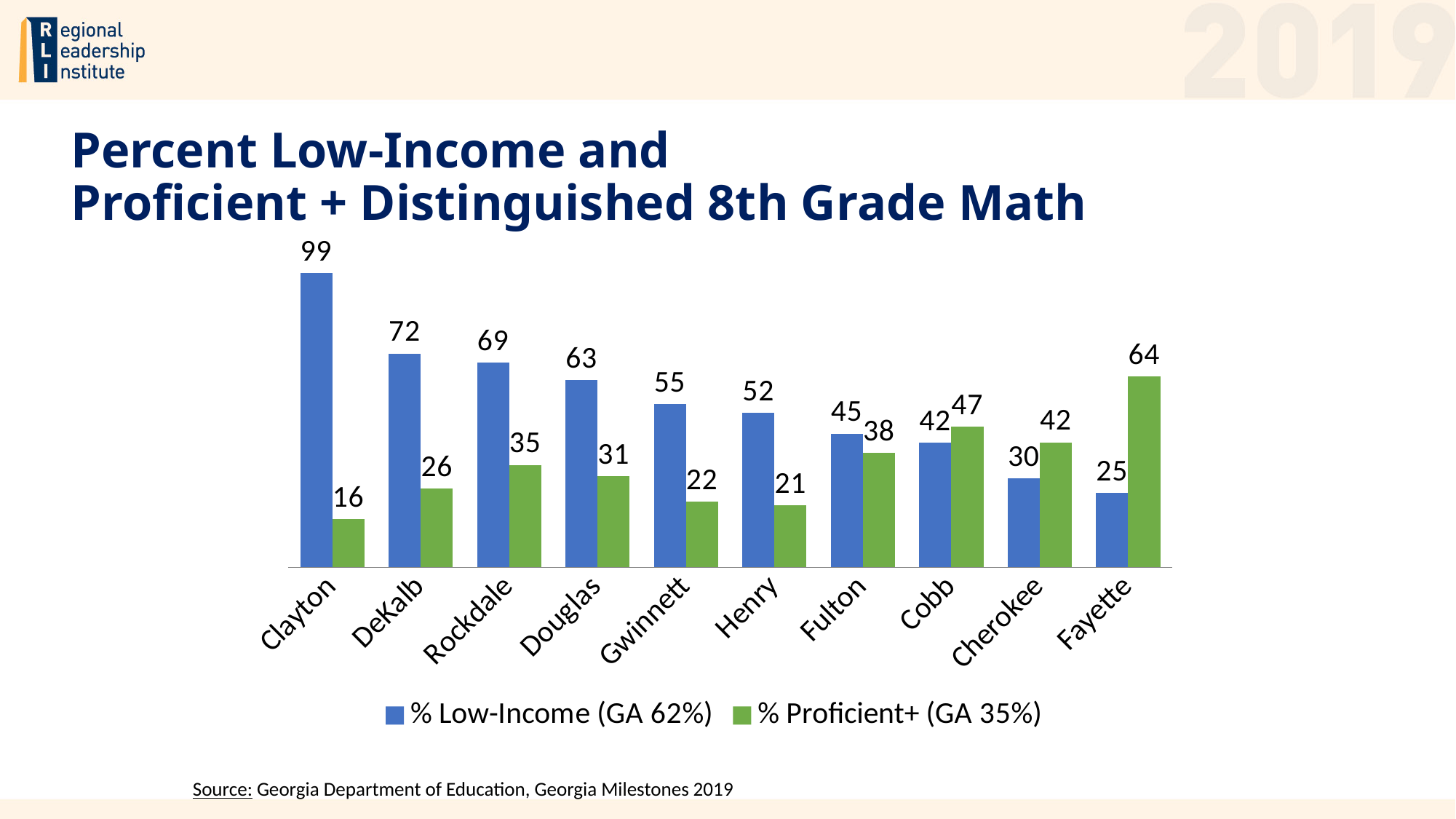
Which county has the lowest % Proficient+ value? Clayton Which county has the highest % Low-Income value? Clayton What is the % Proficient+ value for Fayette? 64 Which is larger for Cobb: % Low-Income or % Proficient+? % Proficient+ What is the % Low-Income value for Clayton? 99 How many series does the legend list? 2 What is the Georgia statewide % Proficient+ value given in the legend? 35% What is the difference between the % Low-Income and % Proficient+ values for DeKalb? 46 How many counties are shown on the x axis? 10 What kind of chart is shown on the slide? Bar chart What is the % Proficient+ value for Gwinnett? 22 Which county has the lowest % Low-Income value? Fayette